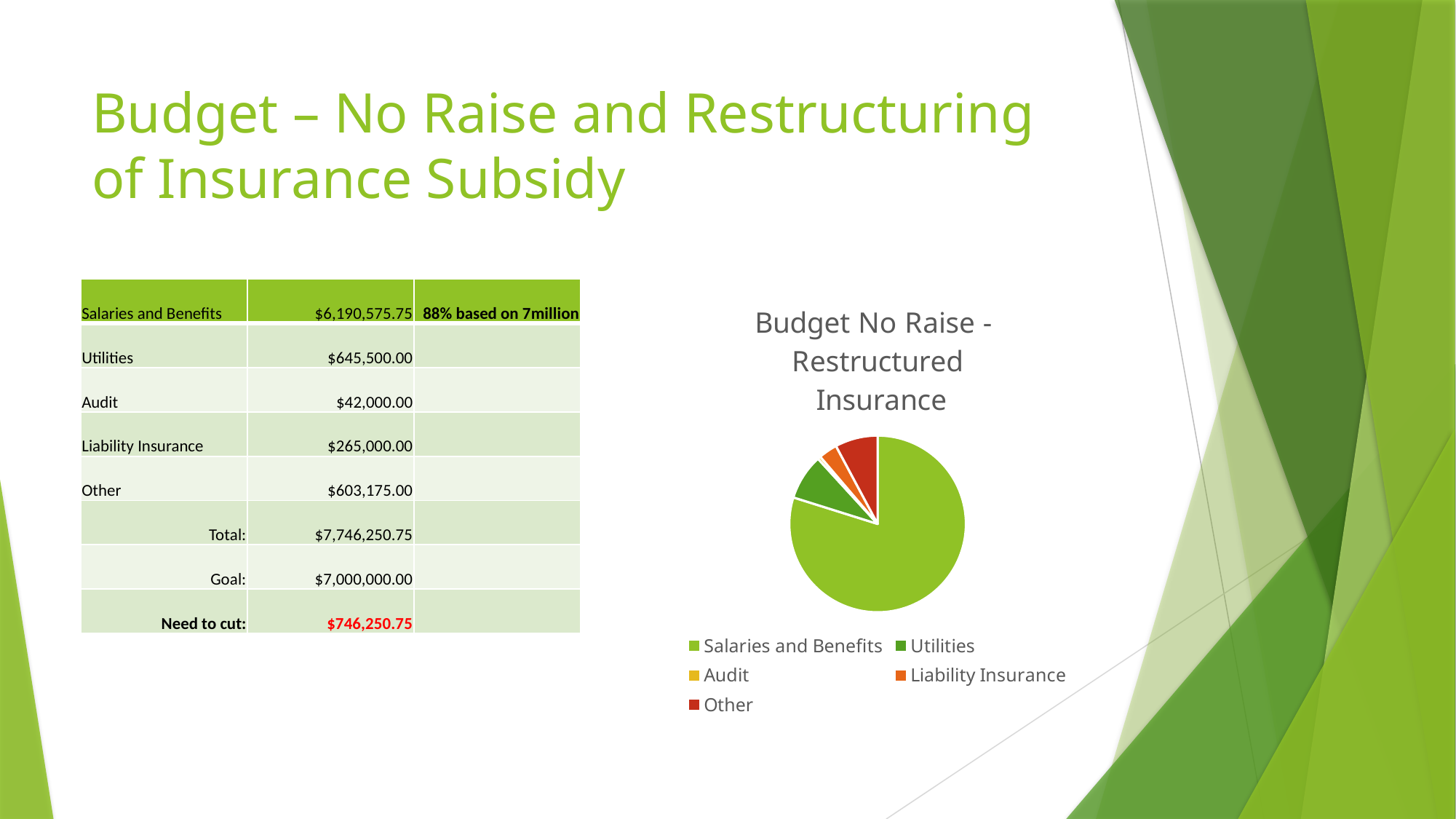
How many categories does the pie chart's legend list? 5 Which slice is larger in the pie chart, Salaries and Benefits or Other? Salaries and Benefits According to the table, what is the value for Utilities? $645,500.00 According to the table, what is the value for Audit? $42,000.00 What is the title of the pie chart? Budget No Raise - Restructured Insurance What colour is the Other slice in the pie chart? red According to the table, what is the value for Salaries and Benefits? $6,190,575.75 Which slice is larger in the pie chart, Utilities or Liability Insurance? Utilities Which category has the largest slice in the pie chart? Salaries and Benefits What kind of chart is shown on the slide? pie chart Which category has the smallest slice in the pie chart? Audit According to the table, what is the total of all budget categories? $7,746,250.75